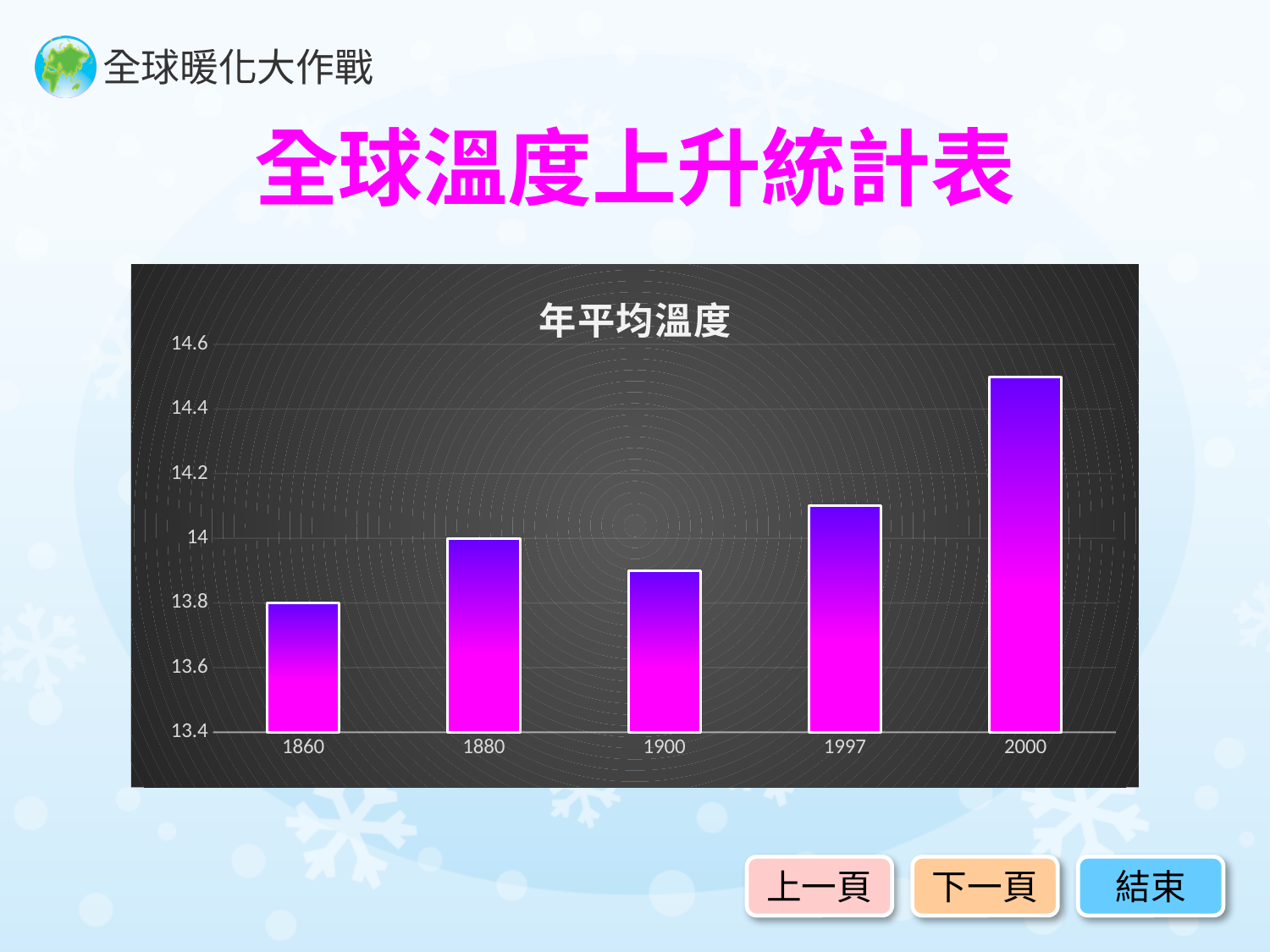
Is the value for 2000 greater or less than 14.4? greater What is the average temperature for 1860? 13.8 How many years are plotted on the chart? 5 What is the difference between the values for 1880 and 1860? 0.2 Which is larger, the value for 1880 or the value for 1900? 1880 Is the value for 1997 greater or less than 14? greater Is the value for 1900 greater or less than 14? less What is the average temperature for 1880? 14 Which year has the highest average temperature? 2000 What kind of chart is shown on the slide? bar chart Which year has the lowest average temperature? 1860 What is the title of the chart? 年平均溫度